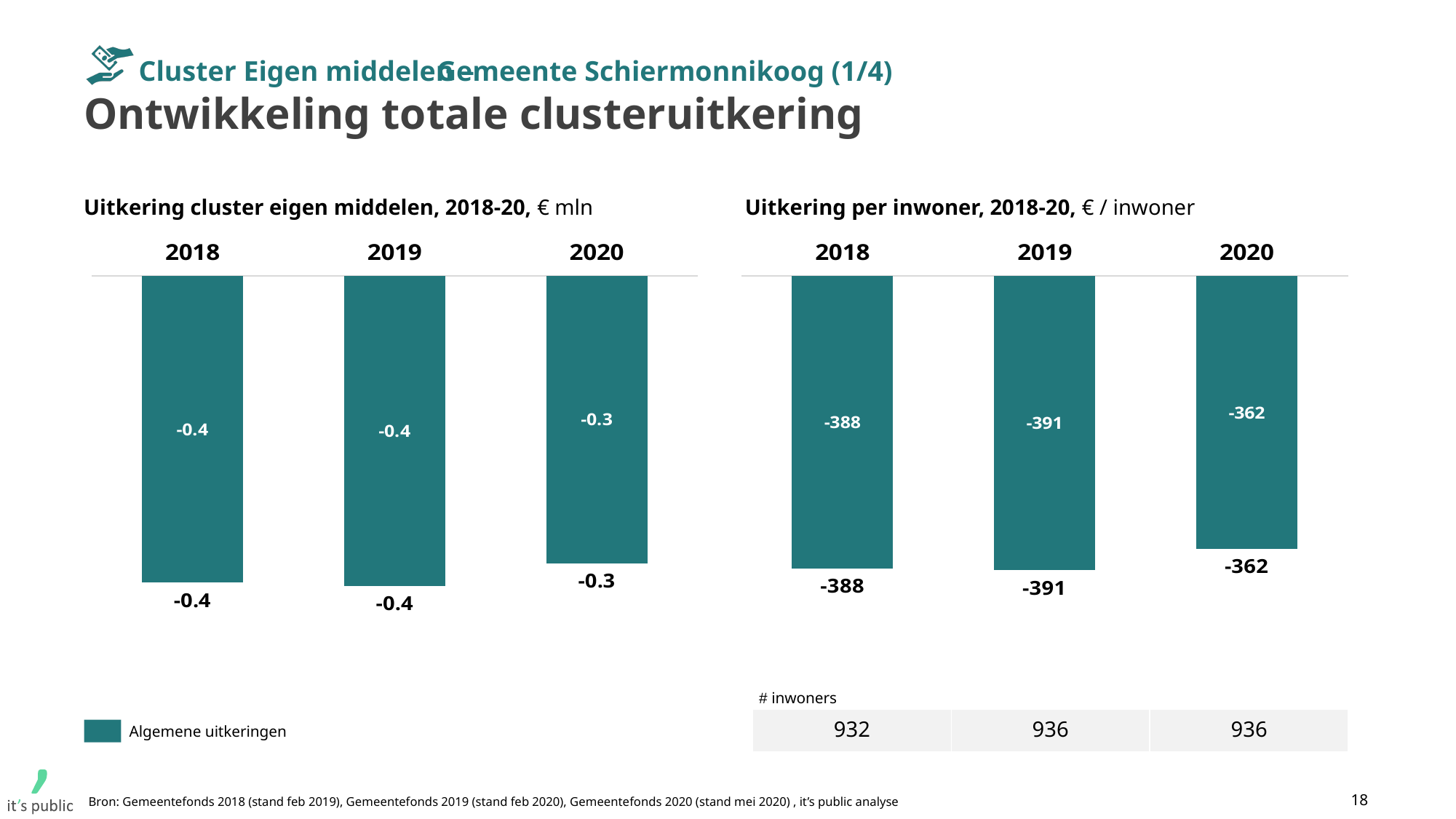
In the chart 'Uitkering per inwoner, 2018-20', which year has the highest (least negative) value? 2020 In the chart 'Uitkering per inwoner, 2018-20', what is the value for 2019? -391 In the chart 'Uitkering per inwoner, 2018-20', which year has the lowest (most negative) value? 2019 In the chart 'Uitkering per inwoner, 2018-20', what is the value for 2020? -362 In the chart 'Uitkering per inwoner, 2018-20', what is the difference between the 2019 value and the 2020 value? 29 In the chart 'Uitkering per inwoner, 2018-20', is the value for 2018 or 2019 more negative? 2019 What is the name of the series shown in the legend on the slide? Algemene uitkeringen In the chart 'Uitkering cluster eigen middelen, 2018-20', what is the value for 2020? -0.3 How many years are shown in the chart 'Uitkering cluster eigen middelen, 2018-20'? 3 According to the '# inwoners' table under the right chart, how many inhabitants are listed for 2018? 932 What type of chart is 'Uitkering per inwoner, 2018-20'? Bar chart In the chart 'Uitkering cluster eigen middelen, 2018-20', what is the value for 2018? -0.4